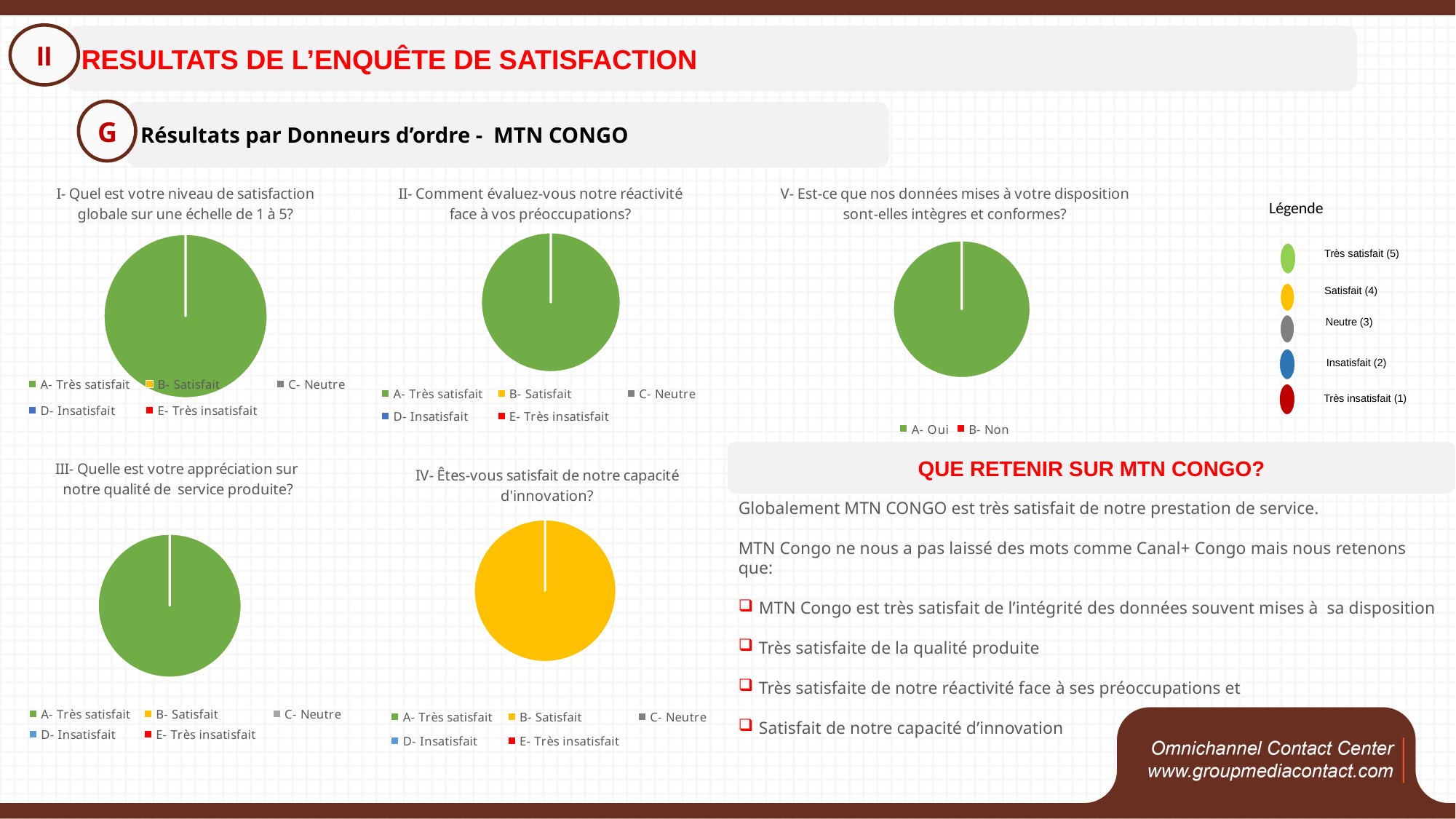
How many entries does the legend list for the chart 'V- Est-ce que nos données mises à votre disposition sont-elles intègres et conformes?' 2 In the chart 'III- Quelle est votre appréciation sur notre qualité de service produite?', which category has the largest share of the pie? A- Très satisfait How many pie charts are shown on the slide? 5 In the chart 'IV- Êtes-vous satisfait de notre capacité d'innovation?', which is larger: the share for A- Très satisfait or the share for B- Satisfait? B- Satisfait What kind of chart is used for 'I- Quel est votre niveau de satisfaction globale sur une échelle de 1 à 5?' Pie chart How many entries does the legend list for the chart 'I- Quel est votre niveau de satisfaction globale sur une échelle de 1 à 5?' 5 In the chart 'V- Est-ce que nos données mises à votre disposition sont-elles intègres et conformes?', which category has the largest share? A- Oui In the chart 'IV- Êtes-vous satisfait de notre capacité d'innovation?', which category has the largest share of the pie? B- Satisfait What colour is the pie in the chart 'IV- Êtes-vous satisfait de notre capacité d'innovation?' Yellow In the legend of the chart 'II- Comment évaluez-vous notre réactivité face à vos préoccupations?', what is the label of the grey entry? C- Neutre